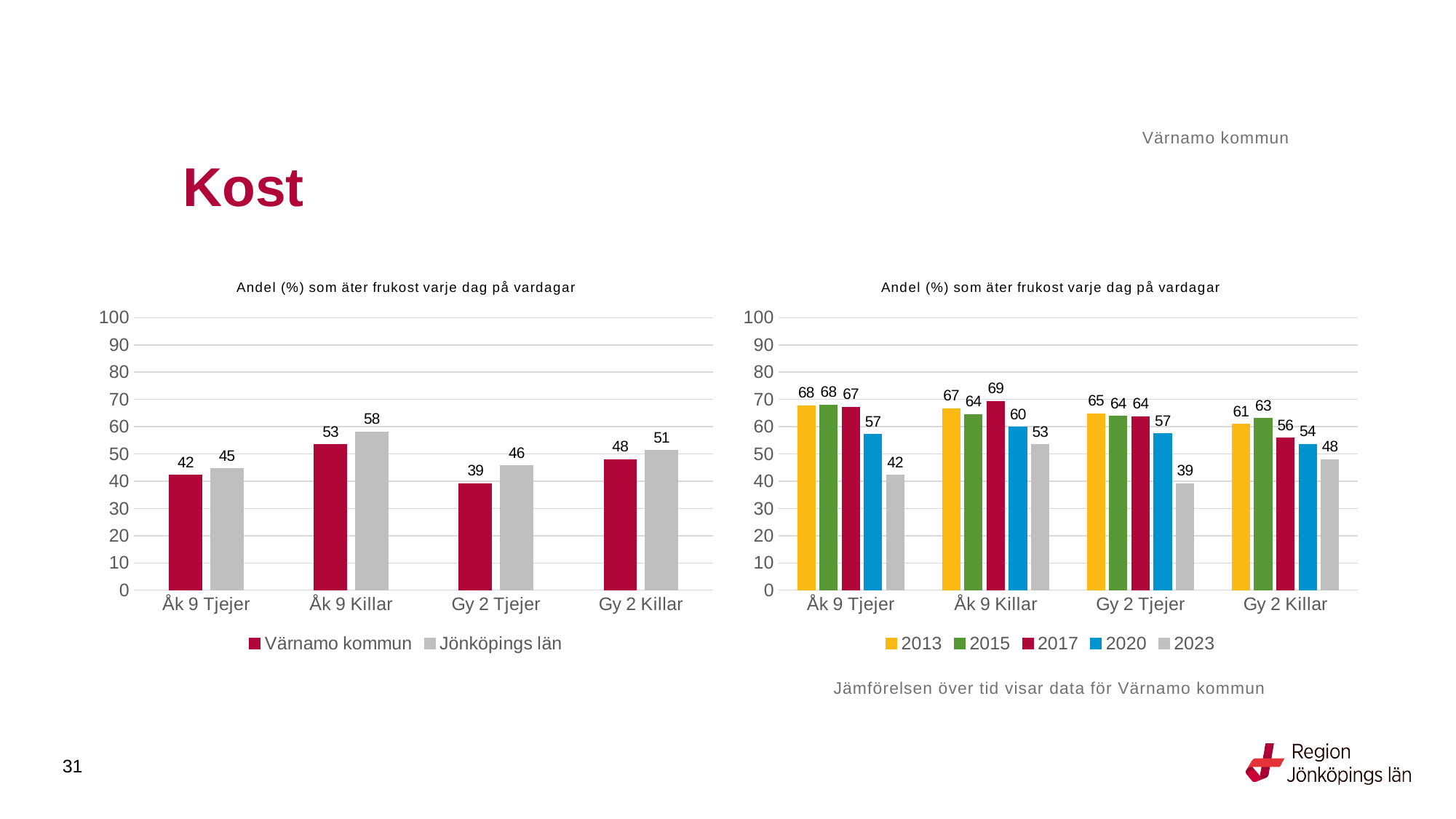
In the right chart, what is the value for 2017 for Åk 9 Killar? 69 In the left chart, how many series does the legend list? 2 In the right chart, which category has the highest value for 2023? Åk 9 Killar In the right chart, what is the value for 2020 for Gy 2 Killar? 54 What kind of chart is the left chart? bar chart In the left chart, what is the value for Värnamo kommun for Åk 9 Killar? 53 In the left chart, which category has the lowest value for Värnamo kommun? Gy 2 Tjejer In the right chart, is the value for 2013 for Åk 9 Tjejer larger or the value for 2023 for Åk 9 Tjejer? 2013 In the right chart, how many series does the legend list? 5 In the right chart, do the values for Gy 2 Tjejer rise or fall from 2013 to 2023? fall In the left chart, what is the value for Jönköpings län for Gy 2 Tjejer? 46 In the left chart, what is the difference between Jönköpings län and Värnamo kommun for Åk 9 Killar? 5